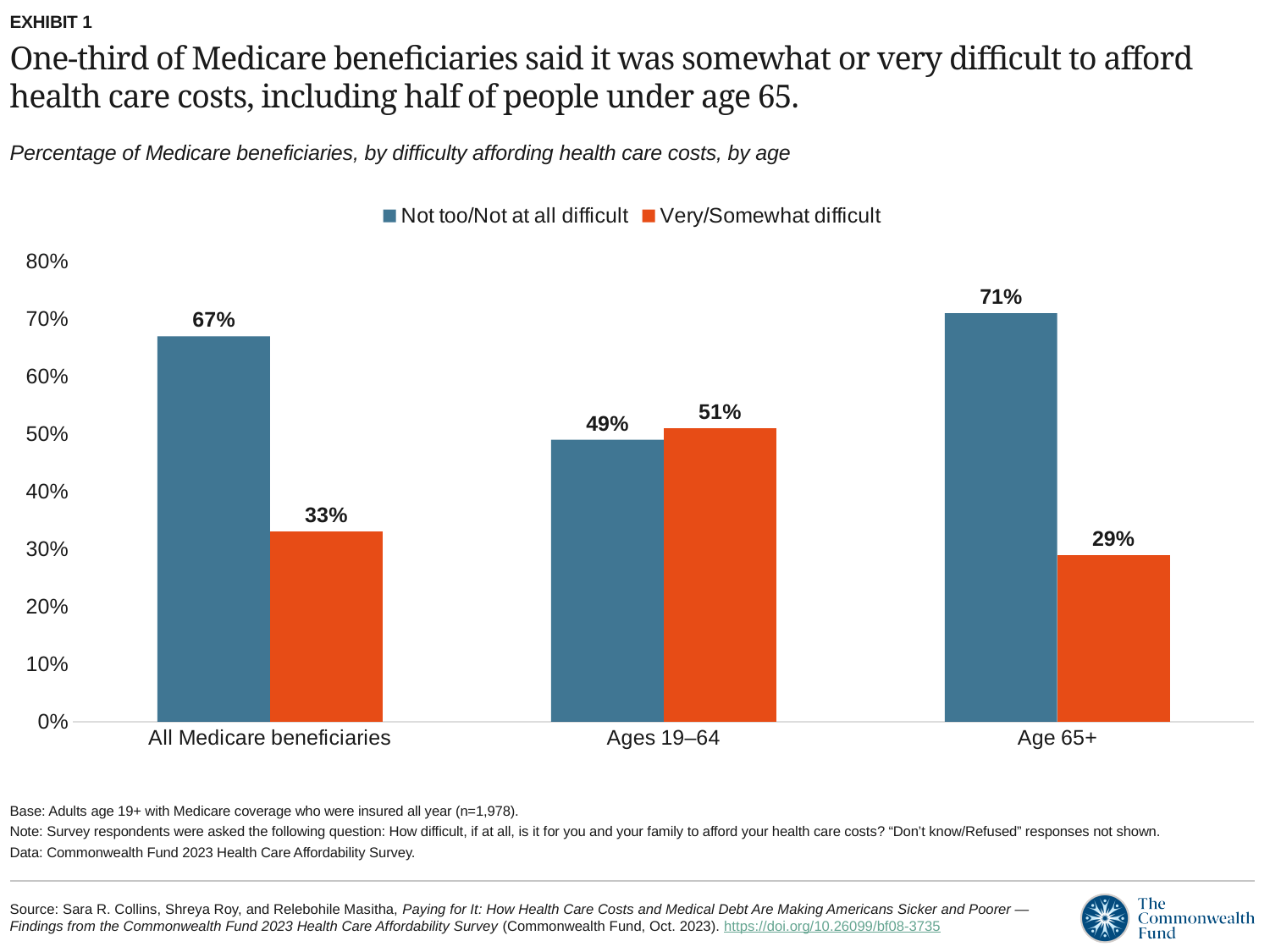
What is the difference between the 'Not too/Not at all difficult' and 'Very/Somewhat difficult' values for all Medicare beneficiaries? 34 percentage points What kind of chart is shown on the slide? Bar chart For the Ages 19–64 group, which is larger: 'Not too/Not at all difficult' or 'Very/Somewhat difficult'? Very/Somewhat difficult How many series does the legend list? 2 What percentage of Medicare beneficiaries ages 19–64 said it was very/somewhat difficult to afford health care costs? 51% Which age group has the highest value for 'Not too/Not at all difficult'? Age 65+ Which colour represents 'Very/Somewhat difficult' in the chart? Orange How many categories are shown on the x axis? 3 What is the value for 'Very/Somewhat difficult' in the Age 65+ group? 29% What percentage of all Medicare beneficiaries said it was not too/not at all difficult to afford health care costs? 67% Is the 'Not too/Not at all difficult' value for Age 65+ greater or less than 60%? greater Which category has the lowest value for 'Very/Somewhat difficult'? Age 65+